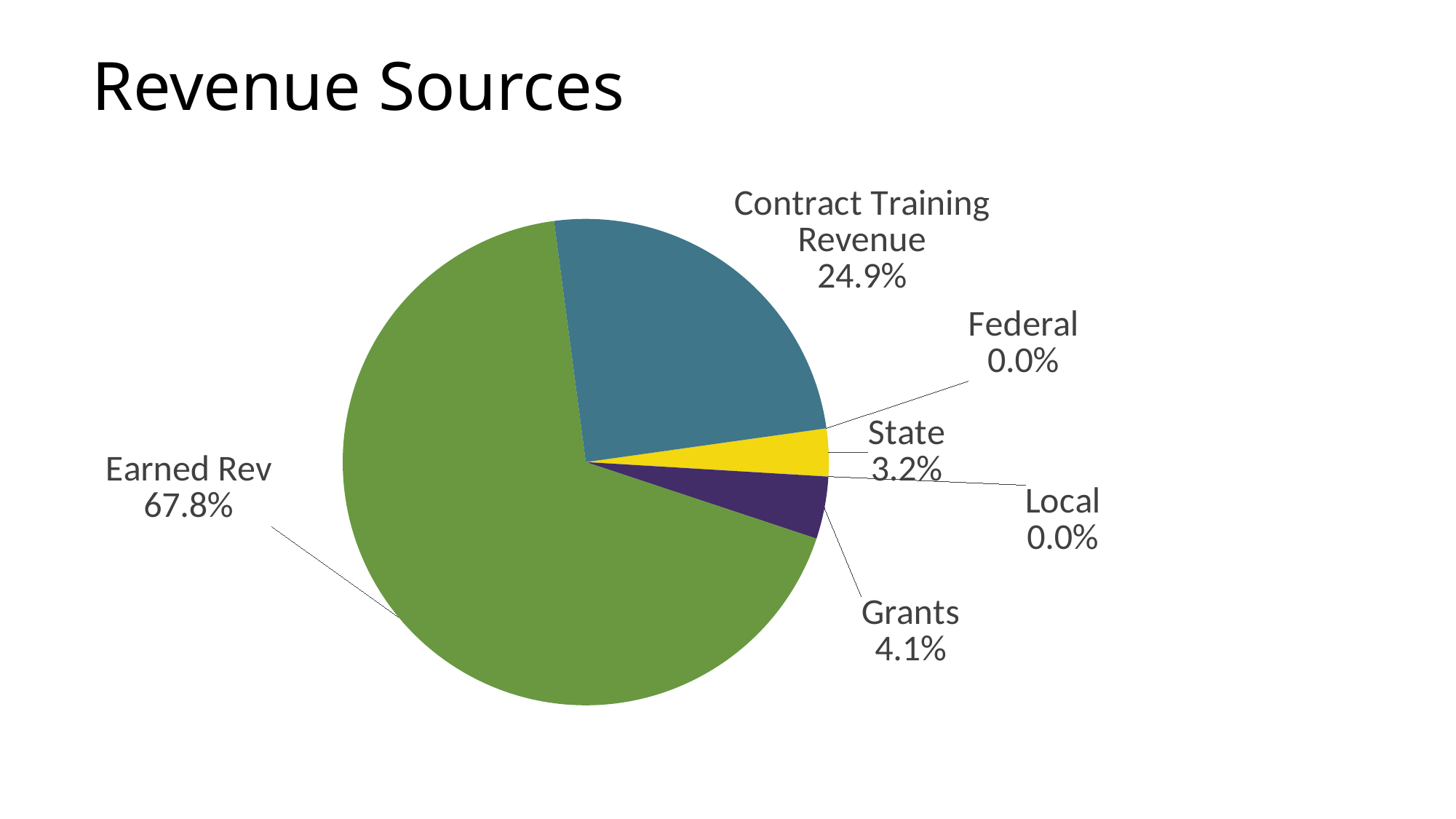
What colour is the Earned Rev slice? green What share of revenue comes from Earned Rev? 67.8% Which revenue source has the largest share? Earned Rev What is the title of the chart? Revenue Sources How many revenue source categories are labelled on the pie chart? 6 Which has a larger share, Grants or State? Grants What share of revenue comes from Contract Training Revenue? 24.9% What share of revenue comes from State? 3.2% What share of revenue comes from Grants? 4.1% What is the difference in share between Earned Rev and Contract Training Revenue? 42.9% What share of revenue comes from Federal? 0.0% What kind of chart is shown on the slide? pie chart